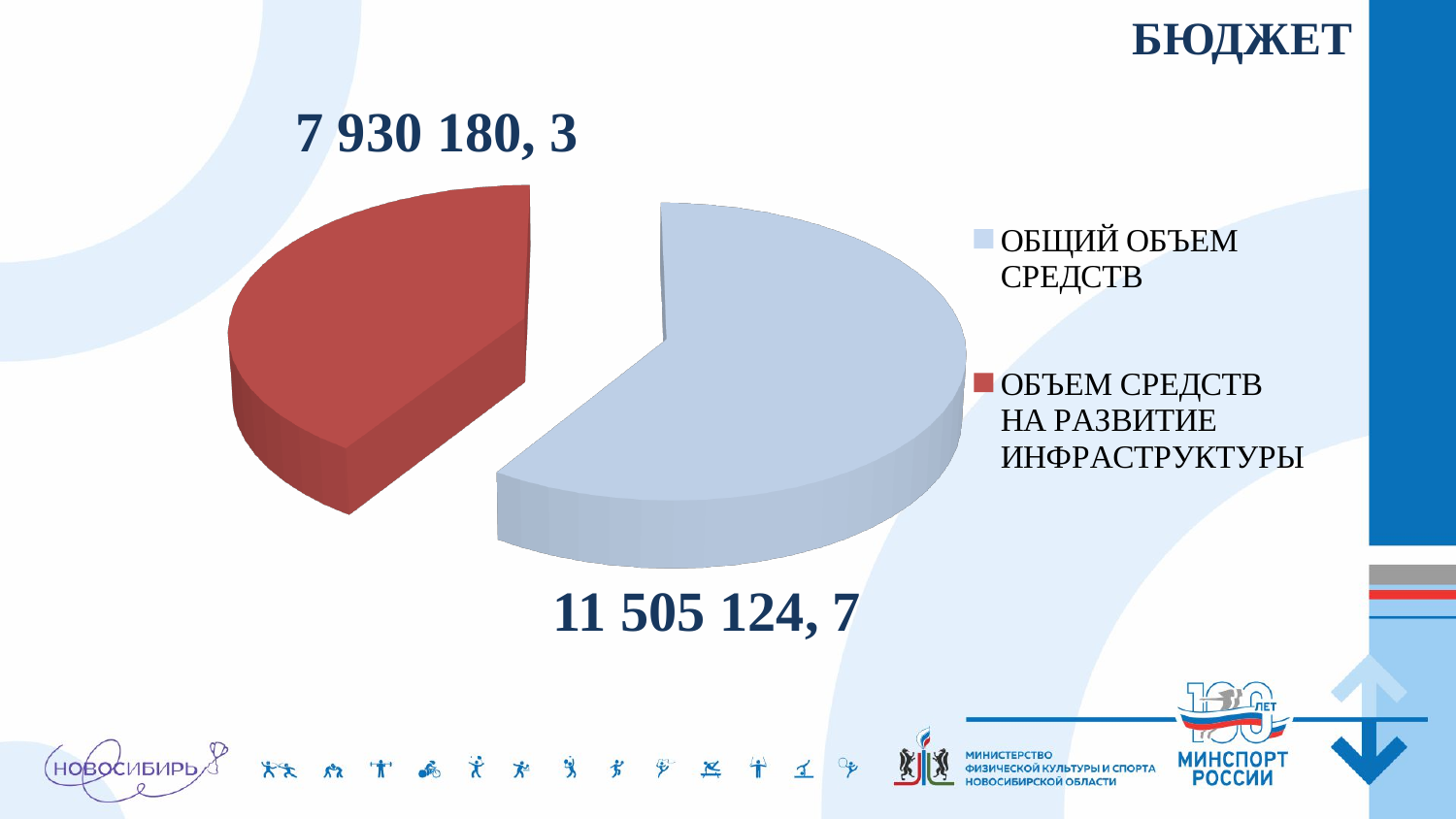
What is the value shown for ОБЪЕМ СРЕДСТВ НА РАЗВИТИЕ ИНФРАСТРУКТУРЫ? 7 930 180, 3 What kind of chart is shown on the slide? pie chart What is the value shown for ОБЩИЙ ОБЪЕМ СРЕДСТВ? 11 505 124, 7 How many slices does the pie chart have? 2 Which is larger: ОБЩИЙ ОБЪЕМ СРЕДСТВ or ОБЪЕМ СРЕДСТВ НА РАЗВИТИЕ ИНФРАСТРУКТУРЫ? ОБЩИЙ ОБЪЕМ СРЕДСТВ Which slice of the pie chart is the largest? ОБЩИЙ ОБЪЕМ СРЕДСТВ How many entries does the legend list? 2 What is the total of the two values shown on the pie chart? 19 435 305, 0 What is the title of the chart on the slide? БЮДЖЕТ Which slice of the pie chart is the smallest? ОБЪЕМ СРЕДСТВ НА РАЗВИТИЕ ИНФРАСТРУКТУРЫ What colour is the slice for ОБЪЕМ СРЕДСТВ НА РАЗВИТИЕ ИНФРАСТРУКТУРЫ? red What is the difference between the value for ОБЩИЙ ОБЪЕМ СРЕДСТВ and the value for ОБЪЕМ СРЕДСТВ НА РАЗВИТИЕ ИНФРАСТРУКТУРЫ? 3 574 944, 4